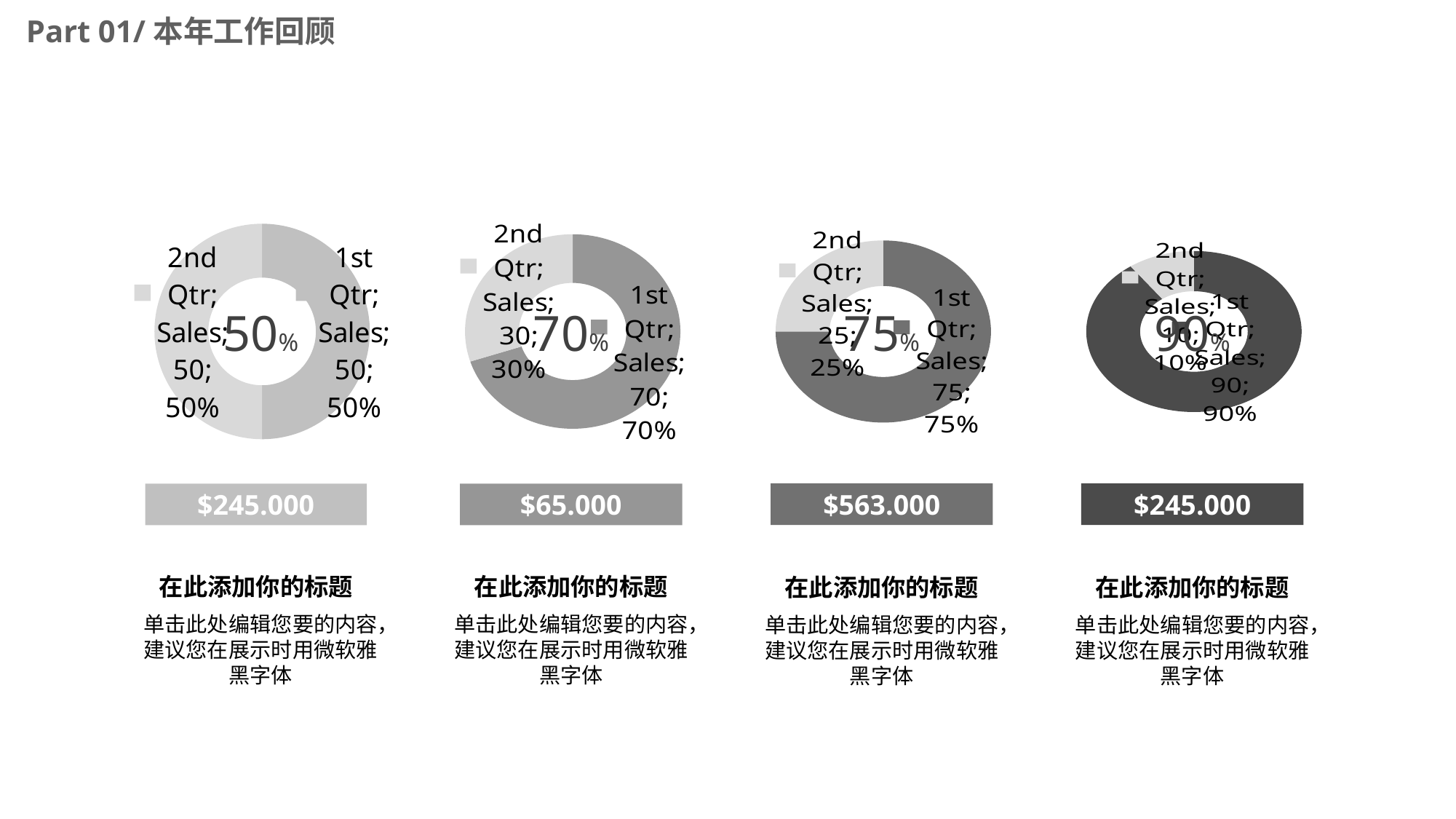
In the third doughnut chart from the left, what is the value for 2nd Qtr? 25 In the second doughnut chart from the left, what is the difference between the 1st Qtr and 2nd Qtr values? 40 In the second doughnut chart from the left, what percentage does 2nd Qtr account for? 30% What type of chart is used for each of the four charts on the slide? Doughnut chart In the rightmost doughnut chart, what percentage does 1st Qtr account for? 90% In the rightmost doughnut chart, which category is the smallest? 2nd Qtr In the second doughnut chart from the left, what is the value for 1st Qtr? 70 In the rightmost doughnut chart, which is larger, 1st Qtr or 2nd Qtr? 1st Qtr In the third doughnut chart from the left, what percentage does 1st Qtr account for? 75% In the third doughnut chart from the left, which category is the largest? 1st Qtr How many categories does the leftmost doughnut chart show? 2 In the leftmost doughnut chart, what is the value for 1st Qtr? 50